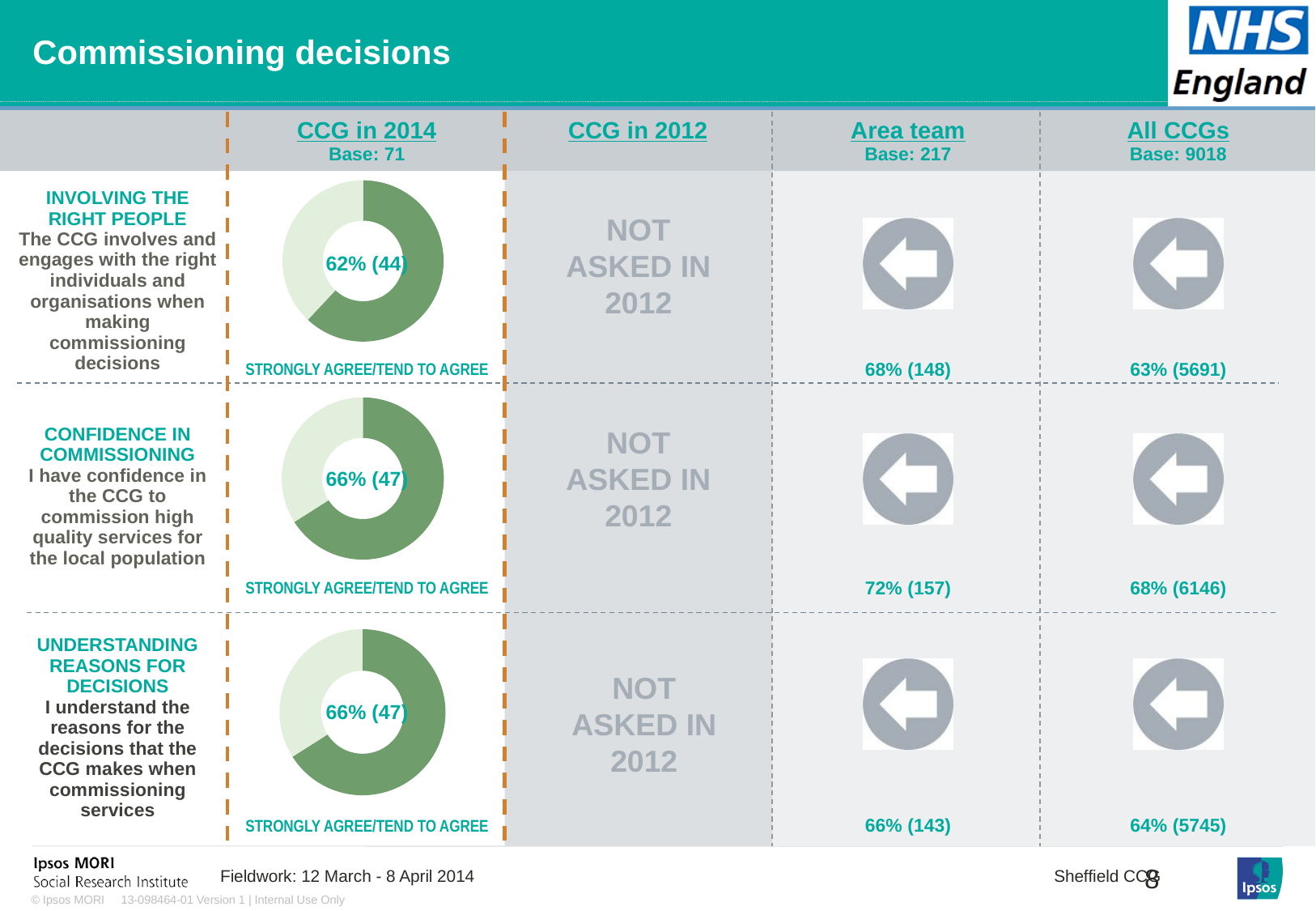
What kind of chart is used to show the CCG in 2014 results? Donut chart How many donut charts are shown on the slide? 3 In the 'Confidence in commissioning' donut chart for CCG in 2014, what percentage strongly agree or tend to agree? 66% What is the difference in percentage points between the 'Confidence in commissioning' donut chart and the 'Involving the right people' donut chart for CCG in 2014? 4 percentage points In the 'Understanding reasons for decisions' donut chart for CCG in 2014, what percentage strongly agree or tend to agree? 66% In the 'Confidence in commissioning' donut chart, how many respondents does the 66% figure represent? 47 In the 'Involving the right people' donut chart, how many respondents does the 62% figure represent? 44 Which of the three CCG in 2014 donut charts shows the lowest percentage agreeing? Involving the right people What is the base (number of respondents) for the CCG in 2014 donut charts? 71 In the 'Involving the right people' donut chart for CCG in 2014, what percentage strongly agree or tend to agree? 62% For 'Involving the right people', is the CCG in 2014 donut chart value (62%) larger or smaller than the Area team value of 68%? Smaller What label appears beneath each of the CCG in 2014 donut charts? STRONGLY AGREE/TEND TO AGREE